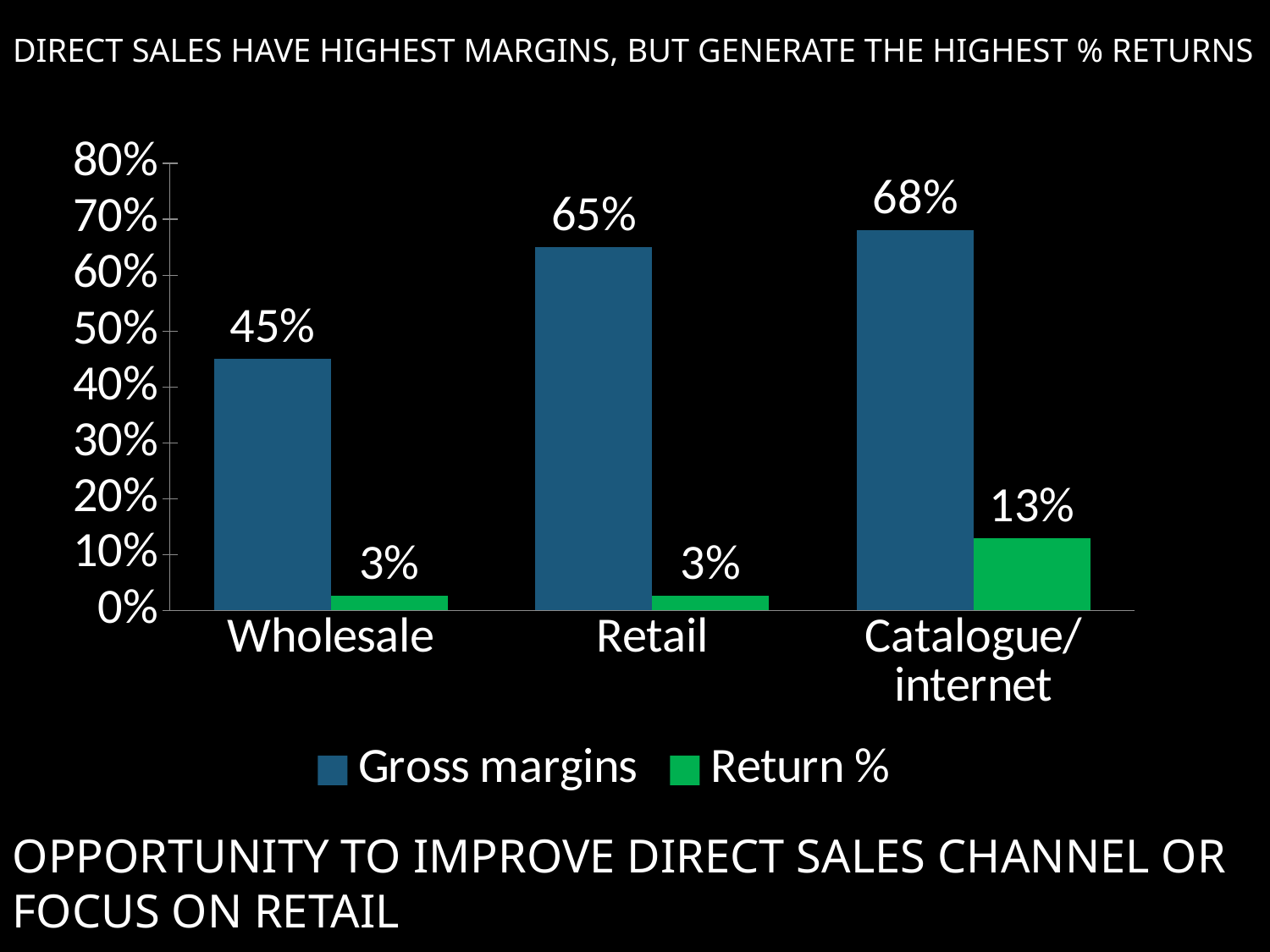
What kind of chart is shown on the slide? Bar chart Which colour represents the Return % series? Green What is the Return % value for Catalogue/internet? 13% Which is larger, the Gross margins for Retail or for Wholesale? Retail What is the difference between the Return % for Catalogue/internet and Retail? 10% How many series does the legend list? 2 What is the difference between the Gross margins for Catalogue/internet and Wholesale? 23% Which category has the highest Gross margins? Catalogue/internet What is the Gross margins value for Wholesale? 45% What is the Gross margins value for Retail? 65% Which category has the lowest Gross margins? Wholesale How many categories are shown on the x axis? 3